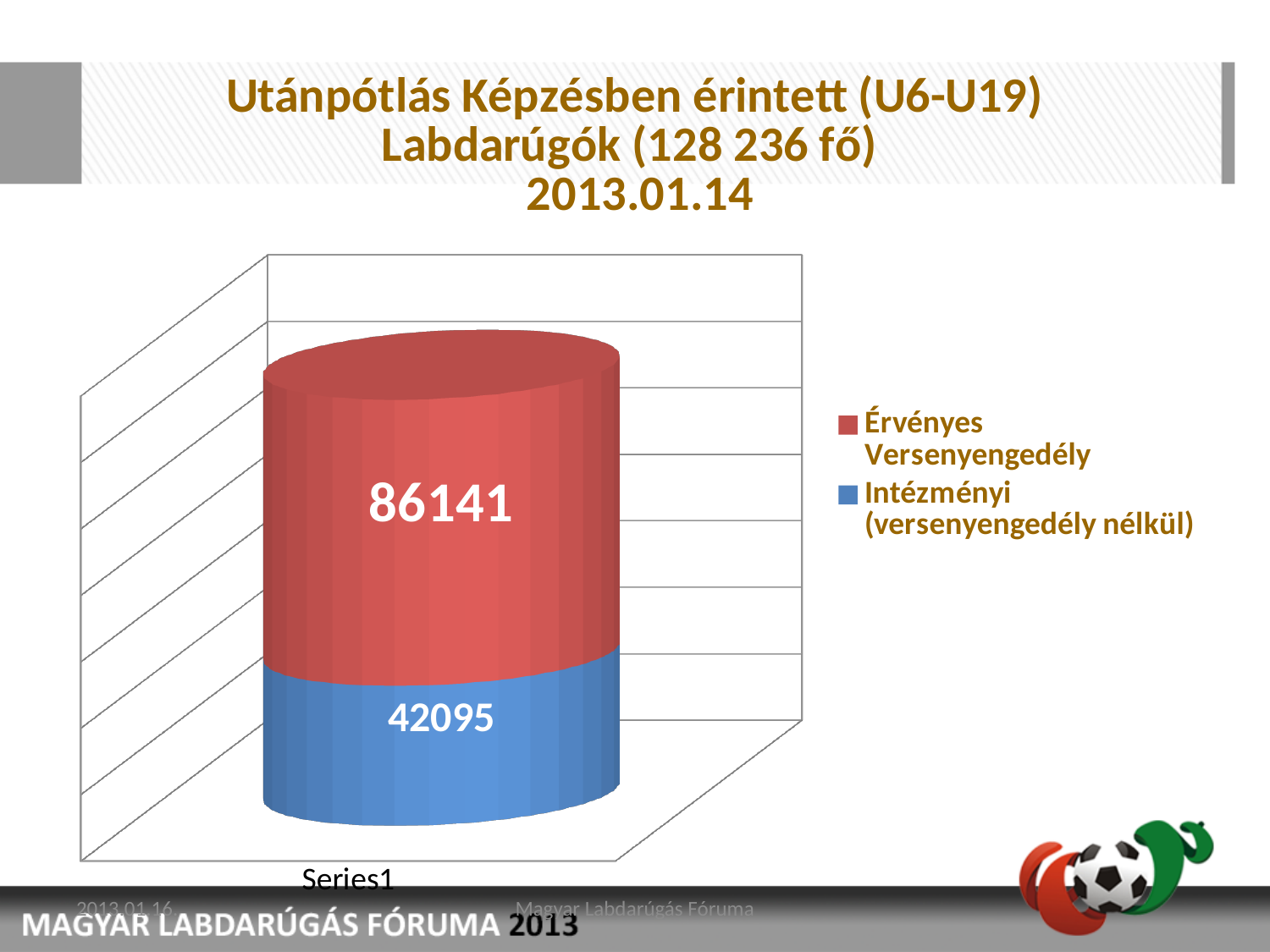
Which series has the lowest value? Intézményi (versenyengedély nélkül) What is the value for Érvényes Versenyengedély? 86141 Which series has the highest value? Érvényes Versenyengedély What kind of chart is shown on the slide? Stacked bar chart What is the value for Intézményi (versenyengedély nélkül)? 42095 How many categories are shown on the x axis? 1 What is the total of the stacked bar? 128236 What is the difference between the Érvényes Versenyengedély value and the Intézményi (versenyengedély nélkül) value? 44046 How many series does the legend list? 2 What is the category label shown on the x axis? Series1 What colour represents Intézményi (versenyengedély nélkül) in the chart? Blue Which is larger, Érvényes Versenyengedély or Intézményi (versenyengedély nélkül)? Érvényes Versenyengedély